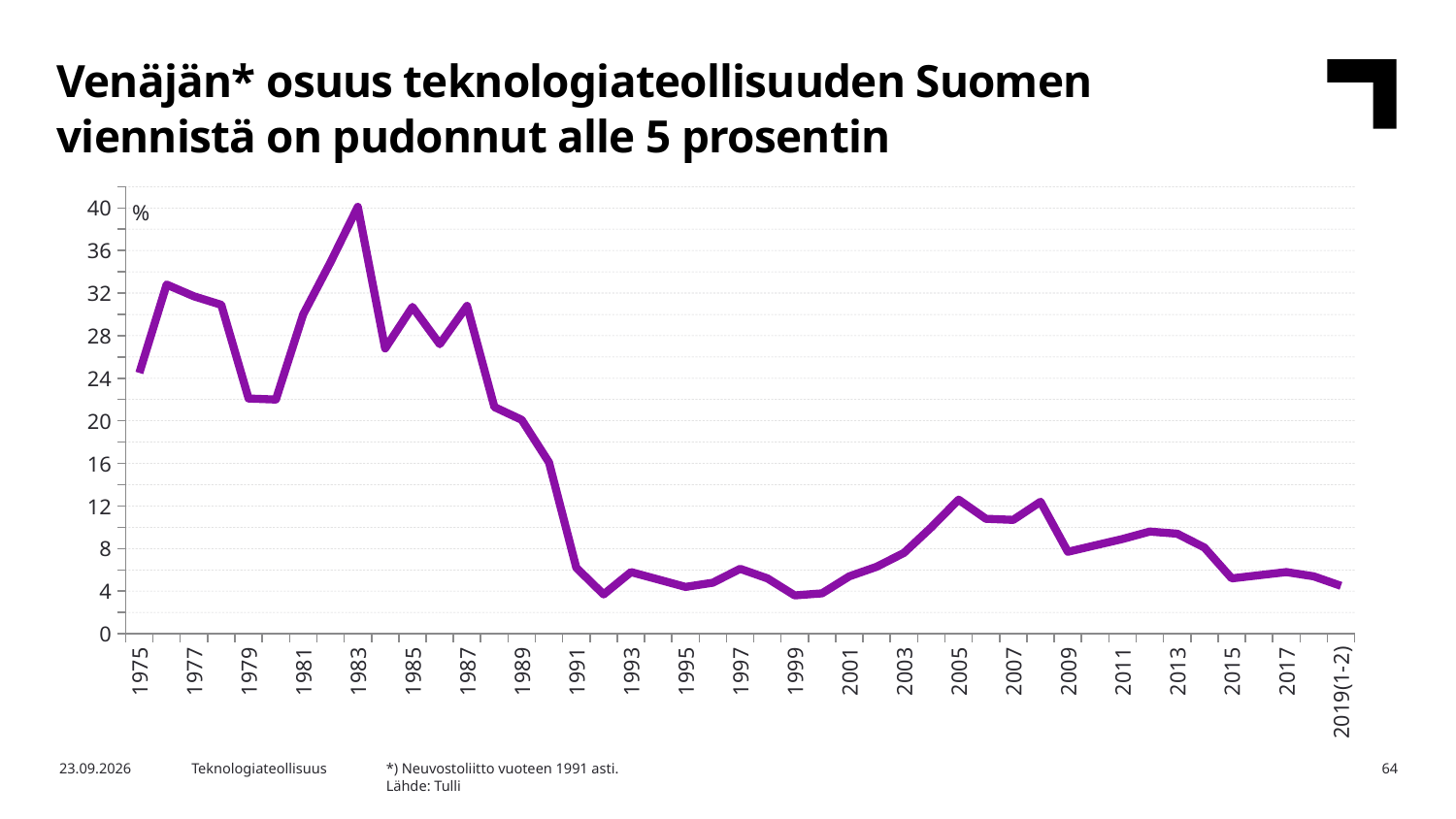
What unit is shown at the top of the vertical axis? % Which year has the larger value, 1983 or 1975? 1983 Is the value for 2019(1-2) greater or less than 8? less Overall, does the line rise or fall from 1975 to 2019(1-2)? fall Is the value for 2013 greater or less than 8? greater Which year has the larger value, 1976 or 2005? 1976 In which year does the line reach its highest value? 1983 Is the value for 1990 greater or less than 12? greater What kind of chart is shown on the slide? line chart